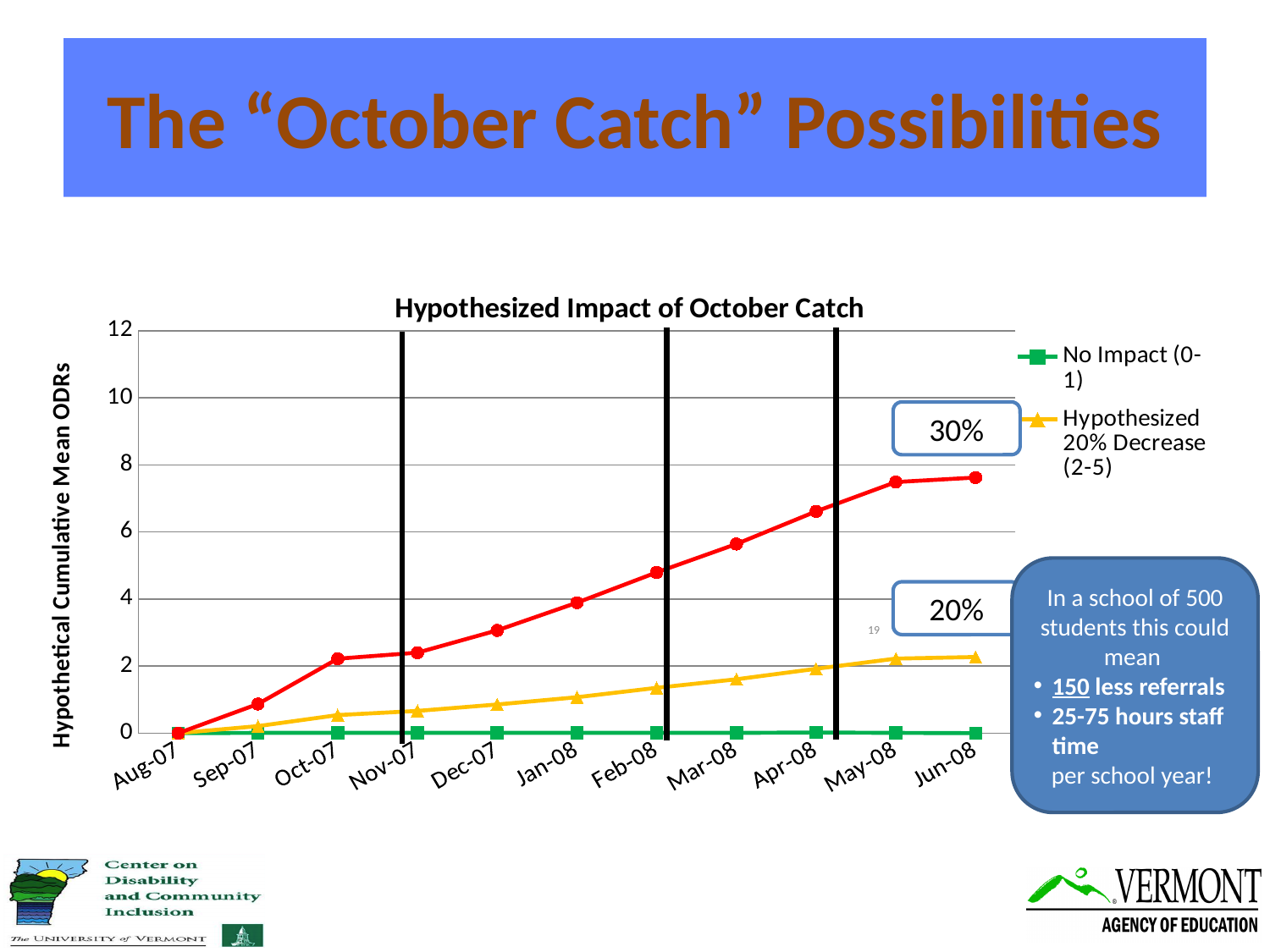
Is the value of the Hypothesized 20% Decrease (2-5) line at Feb-08 greater or less than 2? less Which line has the lowest values across the chart? No Impact (0-1) At Jun-08, which line has the larger value: the red line or the Hypothesized 20% Decrease (2-5) line? the red line How many months are shown along the x axis of the chart? 11 What type of chart is shown on the slide? line chart Does the red line rise or fall from Aug-07 to Jun-08? rise Is the value of the red line at Mar-08 greater or less than 6? less What is the label on the vertical axis of the chart? Hypothetical Cumulative Mean ODRs At which month does the red line reach its highest value? Jun-08 What is the title of the chart? Hypothesized Impact of October Catch Is the value of the red line at Jun-08 greater or less than 6? greater